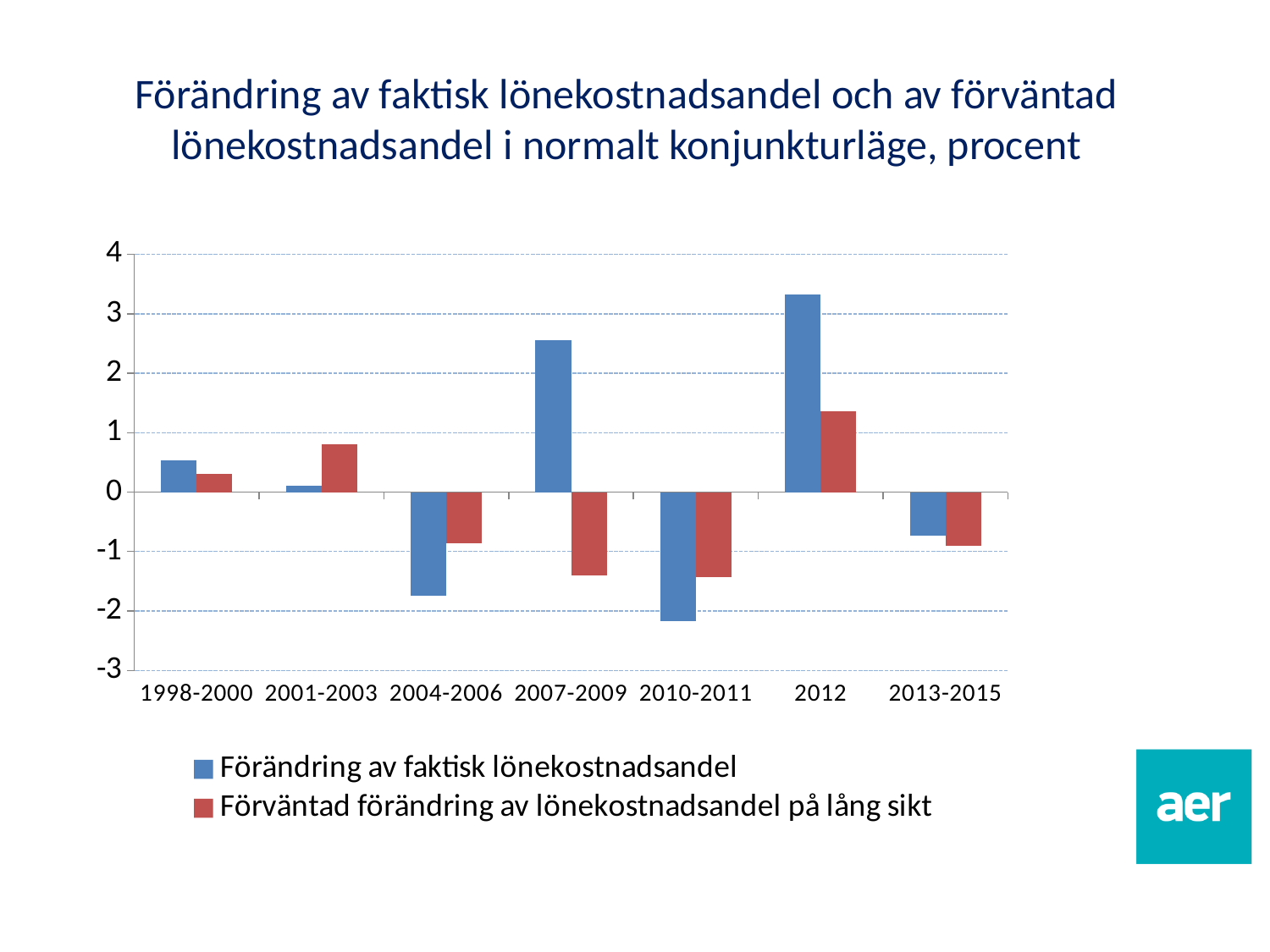
In which period is the value for Förändring av faktisk lönekostnadsandel highest? 2012 Is the value for Förändring av faktisk lönekostnadsandel in 2010-2011 greater or less than -2? less Is the value for Förändring av faktisk lönekostnadsandel in 2012 greater or less than 3? greater In which period is the value for Förväntad förändring av lönekostnadsandel på lång sikt highest? 2012 Is the value for Förväntad förändring av lönekostnadsandel på lång sikt in 2012 greater or less than 1? greater How many period categories are shown on the x axis? 7 Which colour represents Förändring av faktisk lönekostnadsandel in the chart? blue In which period is the value for Förändring av faktisk lönekostnadsandel lowest? 2010-2011 How many series does the legend list? 2 In 2001-2003, which series has the larger value: Förändring av faktisk lönekostnadsandel or Förväntad förändring av lönekostnadsandel på lång sikt? Förväntad förändring av lönekostnadsandel på lång sikt What kind of chart is shown on the slide? bar chart